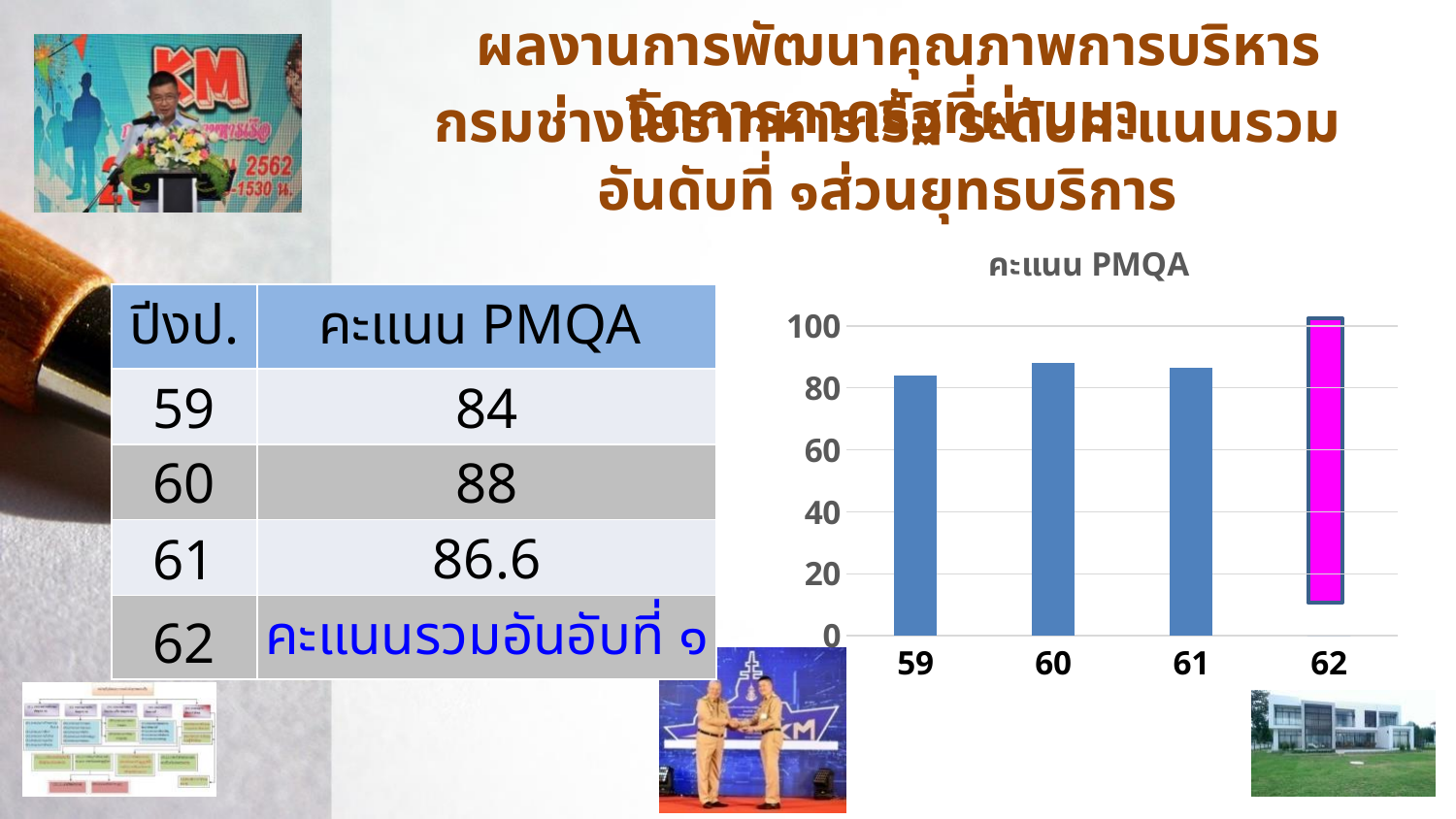
Is the value for year 59 greater or less than 80? greater Among years 59, 60 and 61, which has the highest PMQA score? 60 Which is larger, the value for year 59 or the value for year 60? 60 How many categories are shown on the x axis of the chart? 4 What is the PMQA score for year 59? 84 What is the PMQA score for year 60? 88 Does the value rise or fall from year 59 to year 60? rise What is the PMQA score for year 61? 86.6 What kind of chart is shown on the slide? bar chart Is the value for year 61 greater or less than 100? less What is the difference between the values for year 60 and year 59? 4 What is the title of the chart? คะแนน PMQA